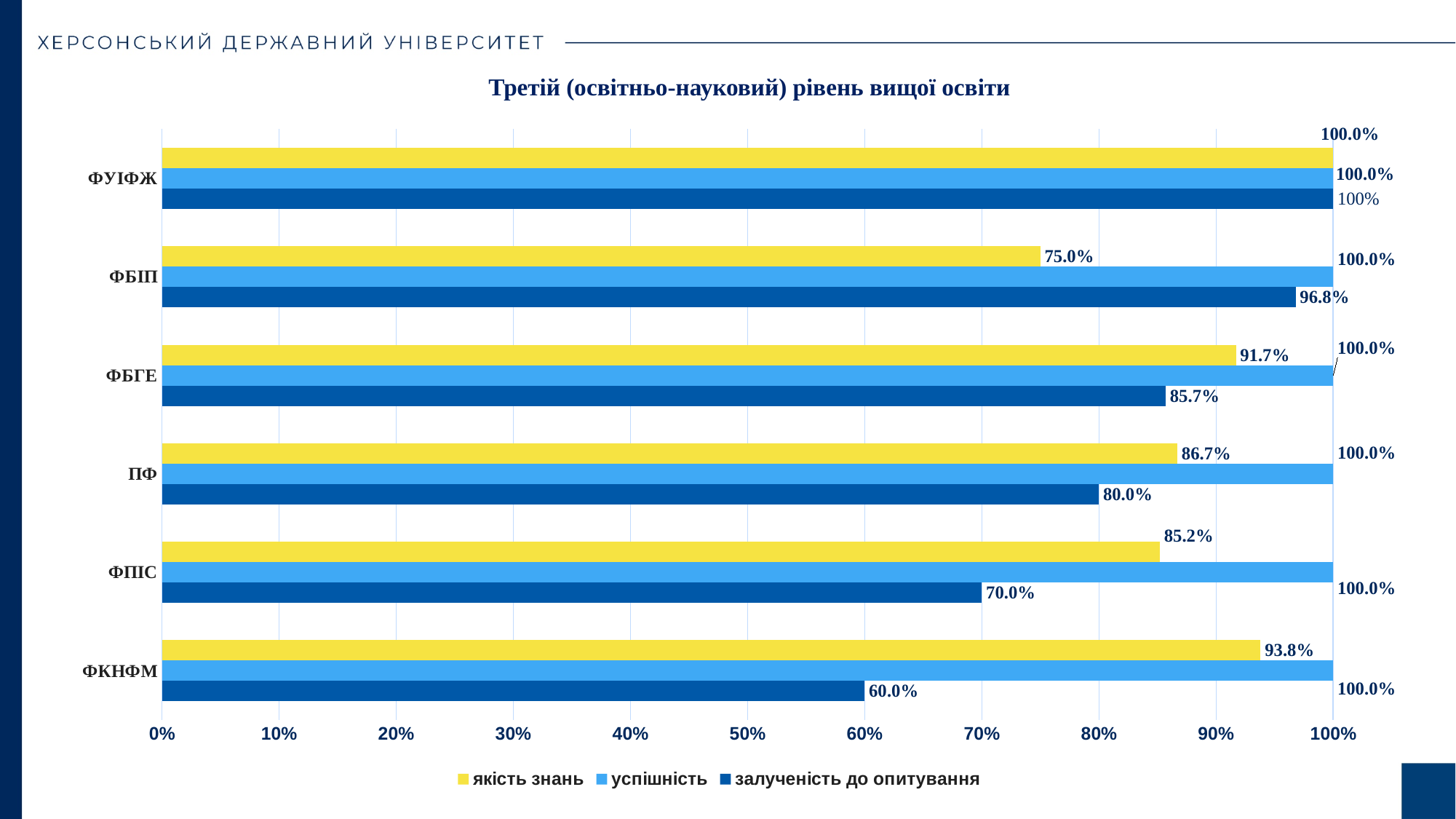
For ФПІС, what is the difference between якість знань and залученість до опитування? 15.2 percentage points What is the value of залученість до опитування for ФКНФМ? 60.0% How many series does the legend list? 3 For ФБГЕ, what is the difference between якість знань and залученість до опитування? 6.0 percentage points How many categories are shown on the chart? 6 What is the value of якість знань for ПФ? 86.7% Which category has the lowest value for залученість до опитування? ФКНФМ What type of chart is shown on the slide? Bar chart Which has the higher якість знань value, ФКНФМ or ПФ? ФКНФМ